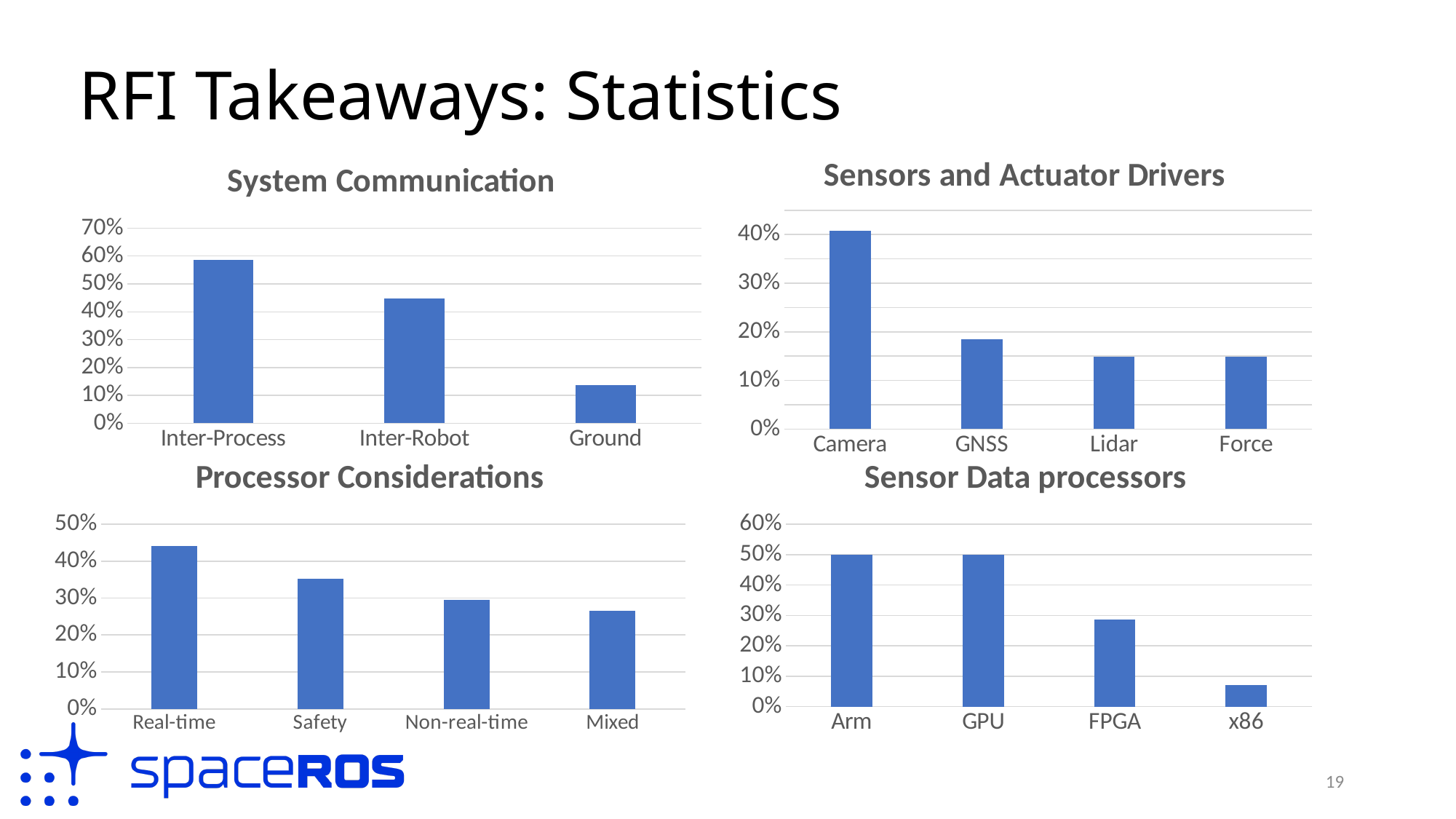
In the System Communication chart, is the value for Inter-Process greater or less than 50%? greater In the System Communication chart, which category has the lowest value? Ground In the Processor Considerations chart, which category has the highest value? Real-time In the Sensor Data processors chart, which category has the lowest value? x86 In the Sensors and Actuator Drivers chart, is the value for GNSS greater or less than 20%? less In the Processor Considerations chart, which is larger, Safety or Non-real-time? Safety In the System Communication chart, how many categories are shown? 3 How many charts are shown on the slide? 4 In the System Communication chart, which category has the highest value? Inter-Process In the Sensor Data processors chart, is the value for FPGA greater or less than 30%? less What kind of chart is the Sensor Data processors chart? bar chart In the Sensors and Actuator Drivers chart, which category has the highest value? Camera